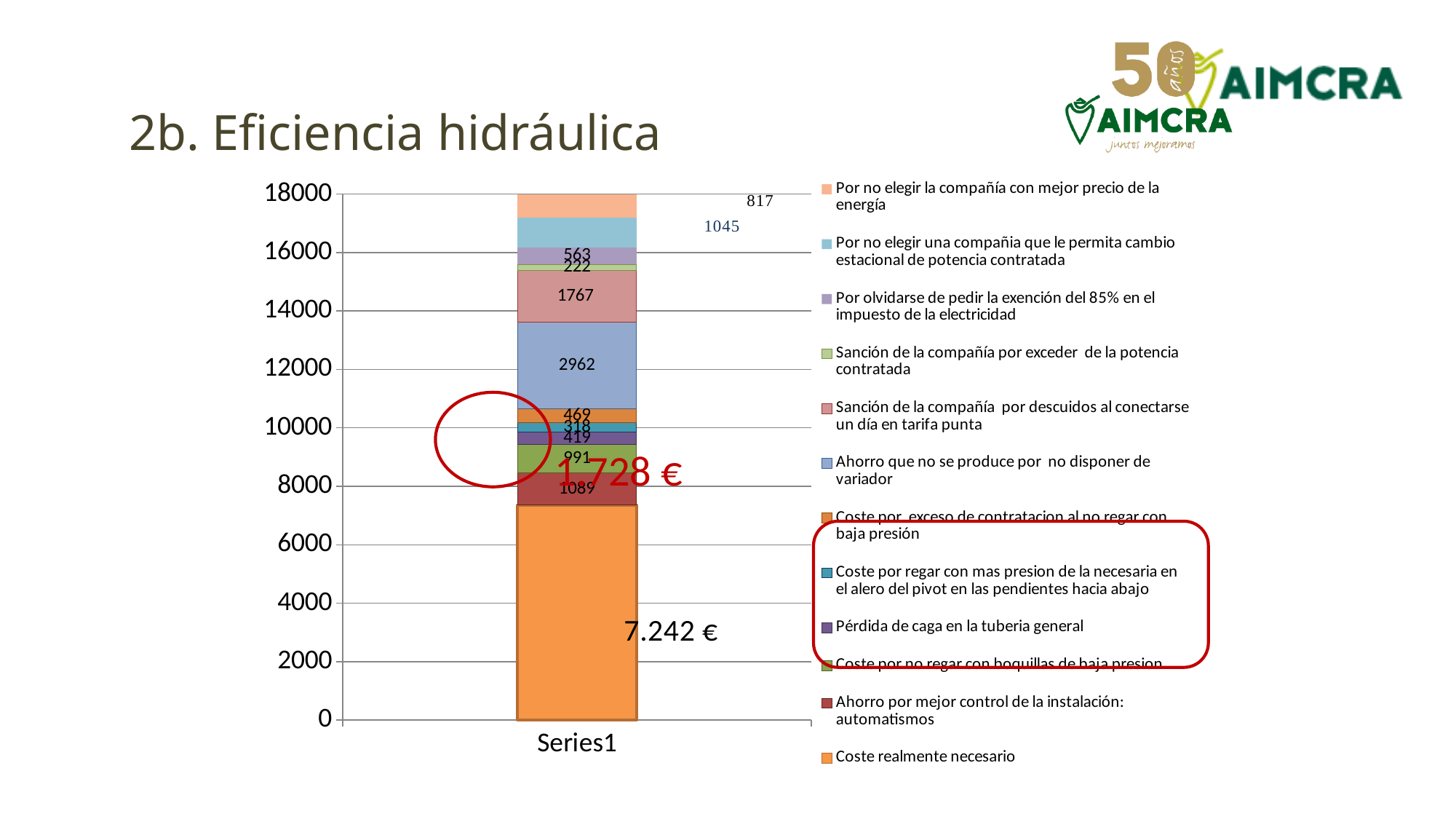
What value is labelled for the 'Coste realmente necesario' segment? 7.242 € Is the total height of the stacked bar greater or less than 16000? greater What is the value of the segment 'Coste por no regar con boquillas de baja presion'? 991 How many series does the legend list? 12 What is the value of the segment 'Ahorro por mejor control de la instalación: automatismos'? 1089 Which is larger: the segment for 'Ahorro que no se produce por no disponer de variador' or the segment for 'Sanción de la compañía por descuidos al conectarse un día en tarifa punta'? Ahorro que no se produce por no disponer de variador What is the value of the segment 'Ahorro que no se produce por no disponer de variador'? 2962 What is the difference between the 'Ahorro que no se produce por no disponer de variador' segment (2962) and the 'Sanción de la compañía por descuidos al conectarse un día en tarifa punta' segment (1767)? 1195 What is the value of the segment 'Sanción de la compañía por descuidos al conectarse un día en tarifa punta'? 1767 What kind of chart is shown on the slide? stacked bar chart Which segment of the stacked bar is the largest? Coste realmente necesario How many categories are plotted on the x axis? 1